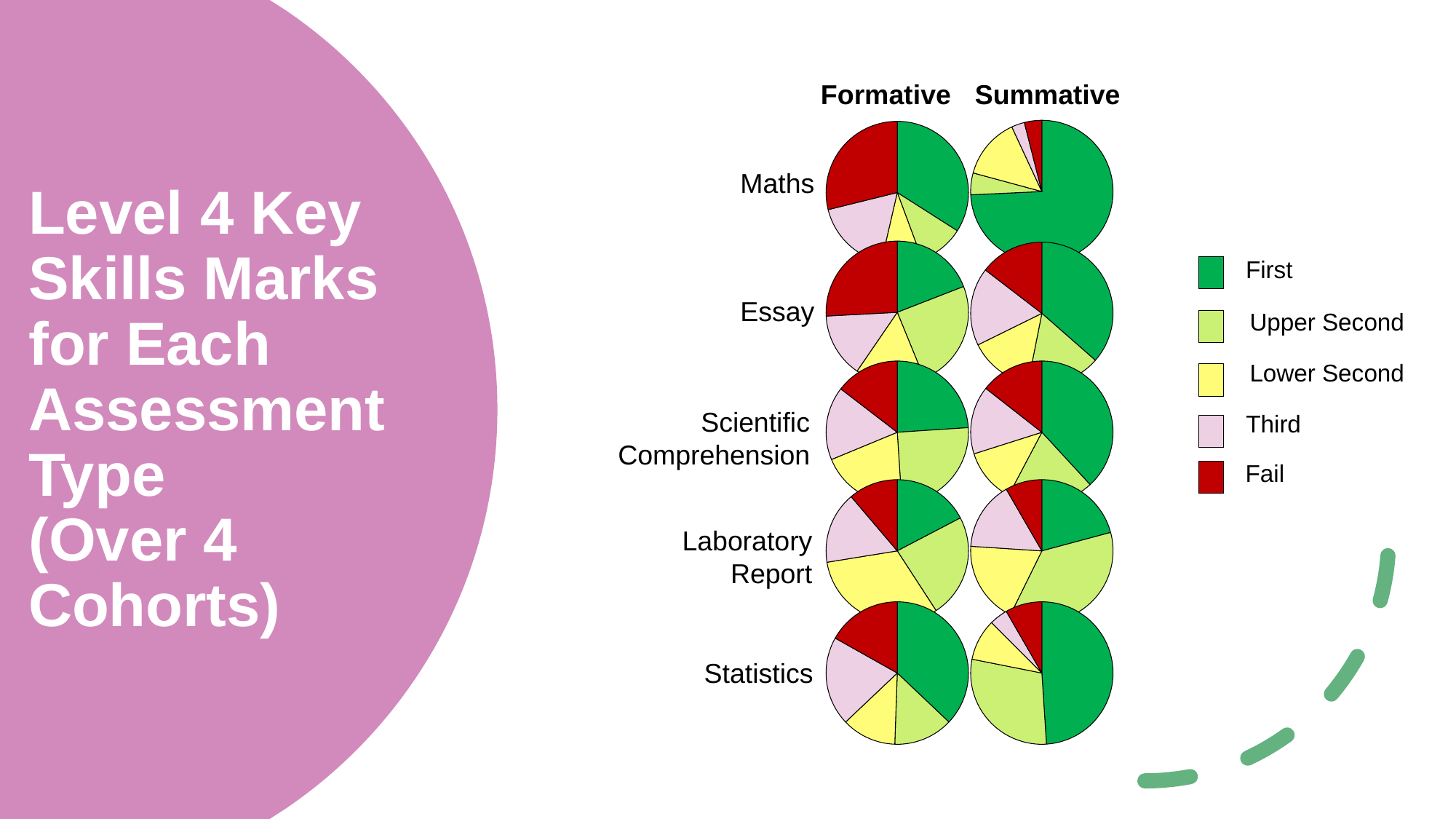
What are the two column headings above the pie charts? Formative and Summative In the Maths Summative pie chart, which category has the largest slice? First How many assessment types are listed down the left of the pie charts? 5 What kind of chart is used on this slide to show the marks for each assessment type? Pie chart How many pie charts are shown on the slide? 10 How many categories does the legend list? 5 In the Maths Formative pie chart, which slice is larger, Fail or Upper Second? Fail In the Scientific Comprehension Summative pie chart, which category has the largest slice? First In the Laboratory Report Summative pie chart, which slice is larger, First or Fail? First In the Statistics Summative pie chart, which category has the largest slice? First Which colour represents Fail in the legend? Red In the Maths Summative pie chart, which slice is larger, First or Fail? First